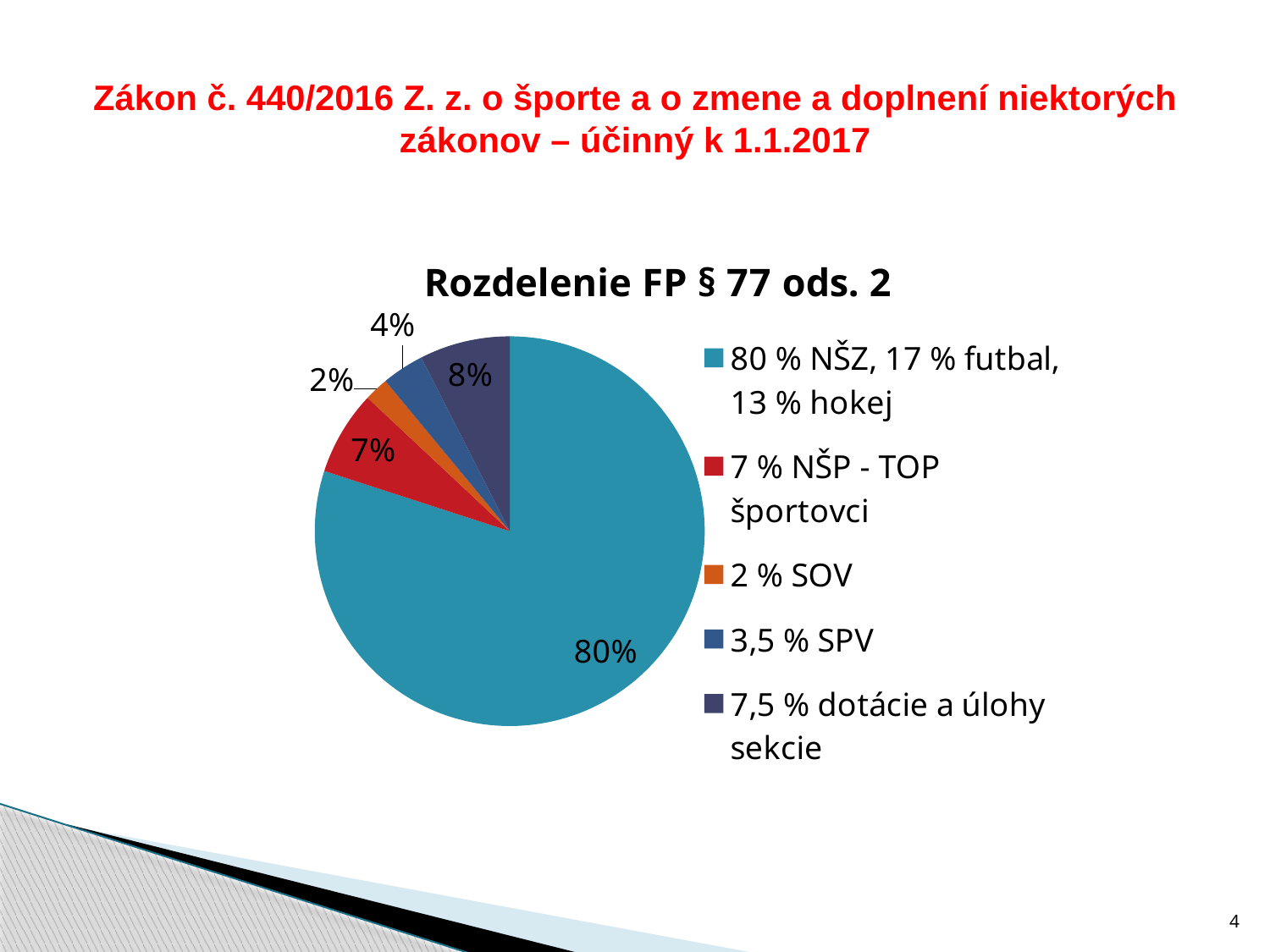
What kind of chart is shown on the slide? pie chart What data label is shown on the slice for NŠZ, futbal and hokej? 80% How many slices does the pie chart have? 5 What data label is shown on the slice for SOV? 2% How many entries does the chart legend list? 5 Which legend category has the smallest slice of the pie? 2 % SOV Which slice is larger: the one for NŠP - TOP športovci or the one for SOV? NŠP - TOP športovci What is the title of the chart? Rozdelenie FP § 77 ods. 2 Which legend category has the largest slice of the pie? 80 % NŠZ, 17 % futbal, 13 % hokej What data label is shown on the slice for SPV? 4% What data label is shown on the slice for dotácie a úlohy sekcie? 8% What data label is shown on the slice for NŠP - TOP športovci? 7%